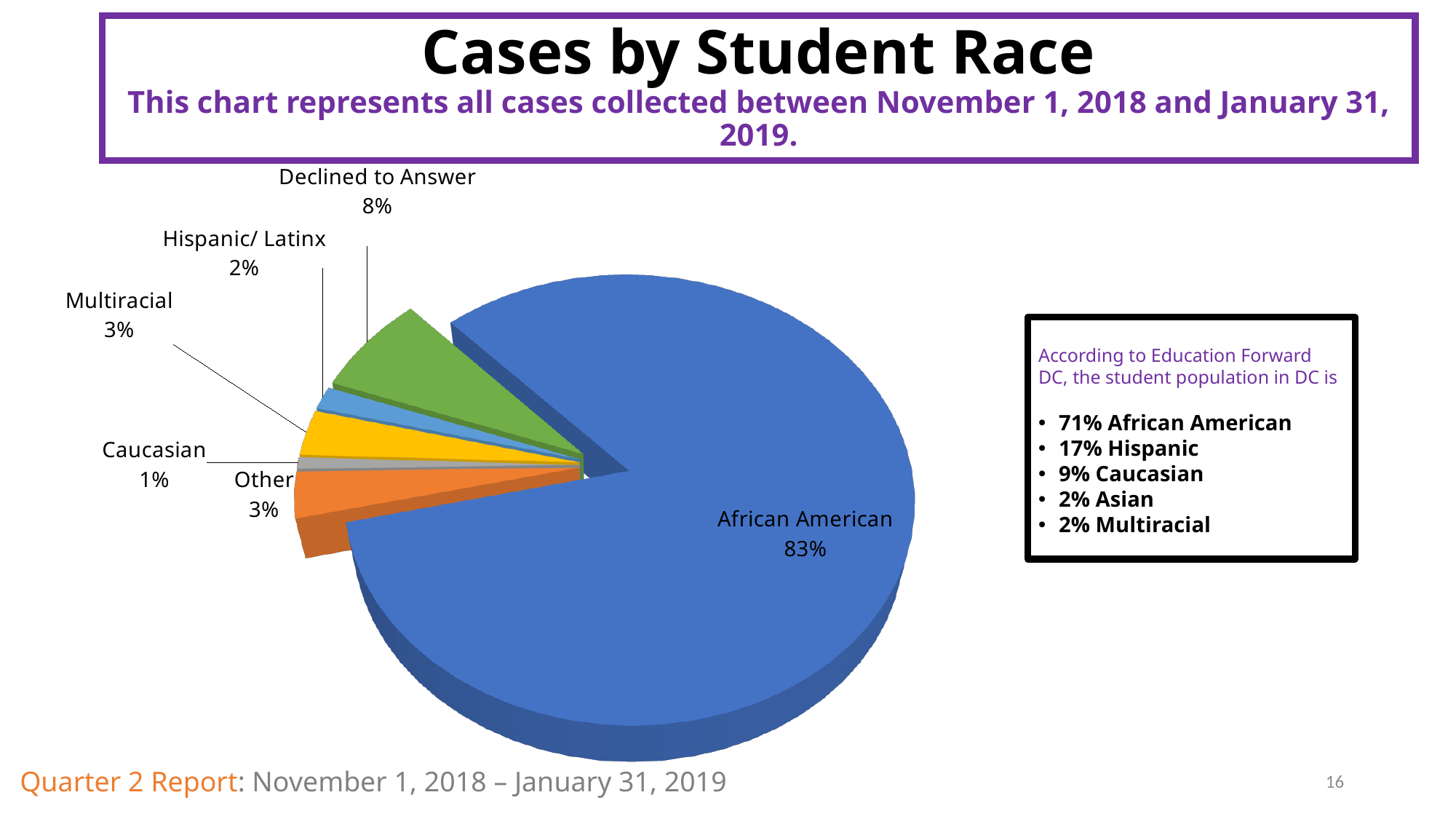
Which category has the largest slice of the pie? African American How many slices does the pie chart have? 6 How many percentage points larger is the African American slice than the Declined to Answer slice? 75 Which is larger, the Multiracial slice or the Hispanic/ Latinx slice? Multiracial What is the title of the chart? Cases by Student Race Which category has the smallest slice of the pie? Caucasian What colour is the African American slice? Blue What kind of chart is shown on the slide? Pie chart What share of cases is Hispanic/ Latinx? 2% What percentage of cases is Caucasian? 1% What share of cases is African American in the pie chart? 83% What percentage of cases is labelled Declined to Answer? 8%